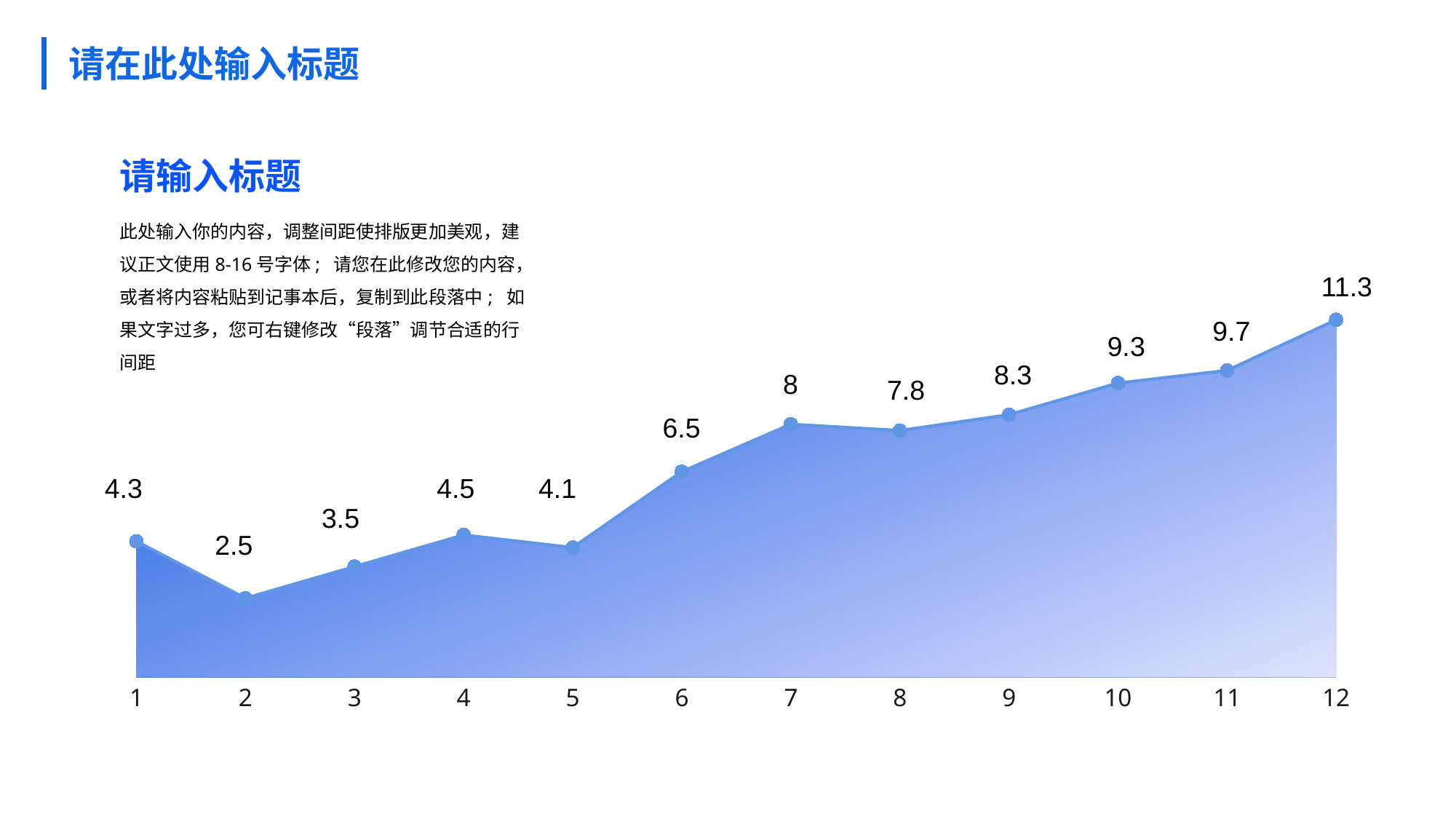
What is the difference between the values at point 6 and point 5? 2.4 What is the value at point 1? 4.3 Which is larger, the value at point 7 or the value at point 8? Point 7 What is the value at point 12? 11.3 Which is larger, the value at point 4 or the value at point 5? Point 4 How many data points are plotted on the chart? 12 Do the values generally rise or fall from point 1 to point 12? Rise Which point on the x axis has the lowest value? 2 What kind of chart is shown on the slide? Area chart Which point on the x axis has the highest value? 12 What is the difference between the values at point 12 and point 1? 7 What is the value at point 7? 8